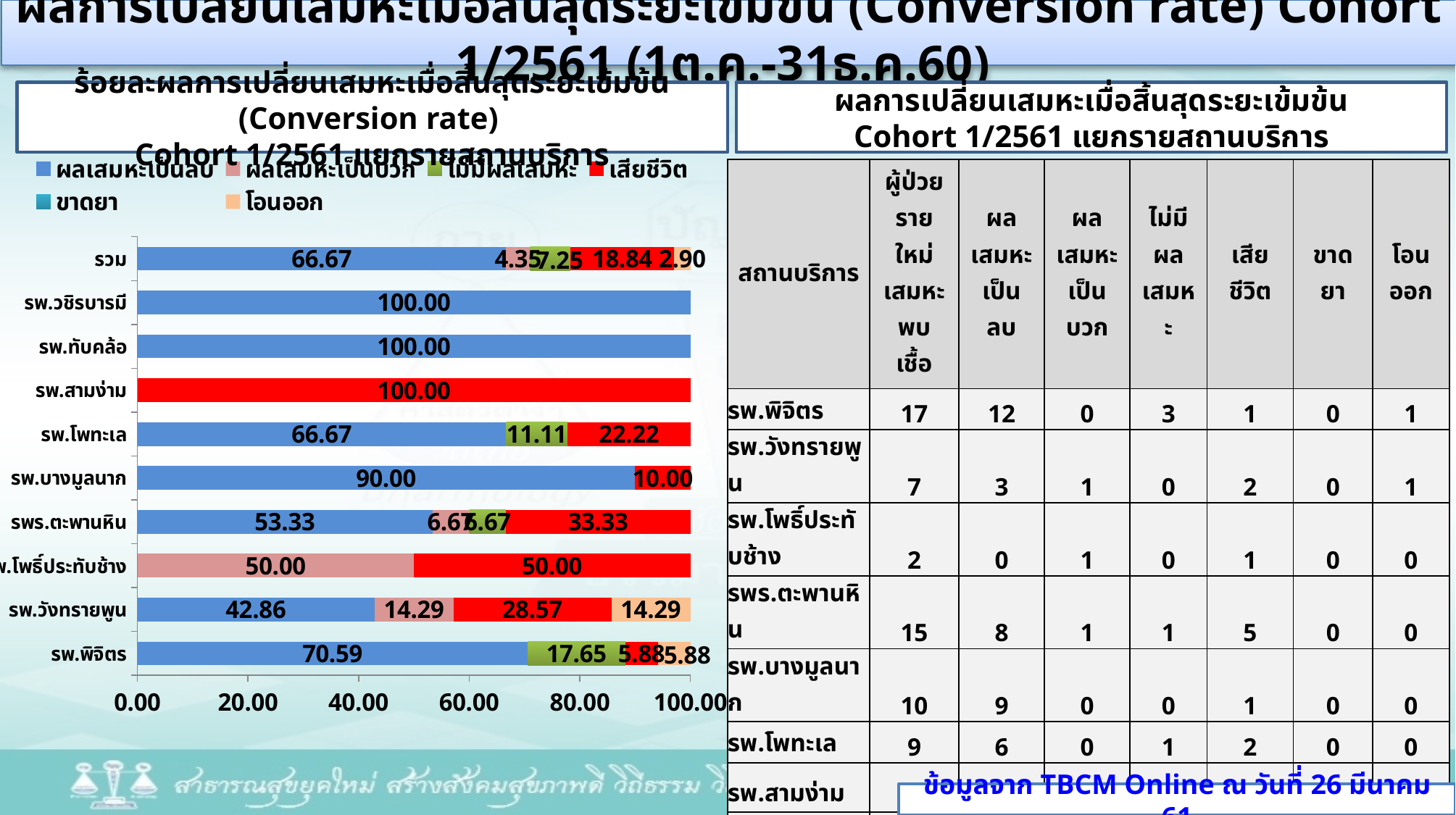
In the bar chart, what is the value of ไม่มีผลเสมหะ for รพ.โพทะเล? 11.11 How many categories (hospitals including รวม) are plotted on the bar chart? 10 In the bar chart, what is the difference between the ผลเสมหะเป็นลบ value for รพ.บางมูลนาก and for รพร.ตะพานหิน? 36.67 In the bar chart, what is the value of เสียชีวิต for รพ.สามง่าม? 100.00 How many series does the legend of the bar chart list? 6 What colour represents เสียชีวิต in the bar chart? red In the bar chart, what is the value of ผลเสมหะเป็นลบ for รพ.พิจิตร? 70.59 What kind of chart is shown on the left of the slide? bar chart In the bar chart, which hospital has the lowest ผลเสมหะเป็นลบ value among those with a blue segment? รพ.วังทรายพูน In the bar chart, what is the value of ผลเสมหะเป็นลบ for รวม? 66.67 In the bar chart, what is the value of เสียชีวิต for รพ.วังทรายพูน? 28.57 In the bar chart, which is larger: the เสียชีวิต value for รพร.ตะพานหิน or for รพ.โพทะเล? รพร.ตะพานหิน